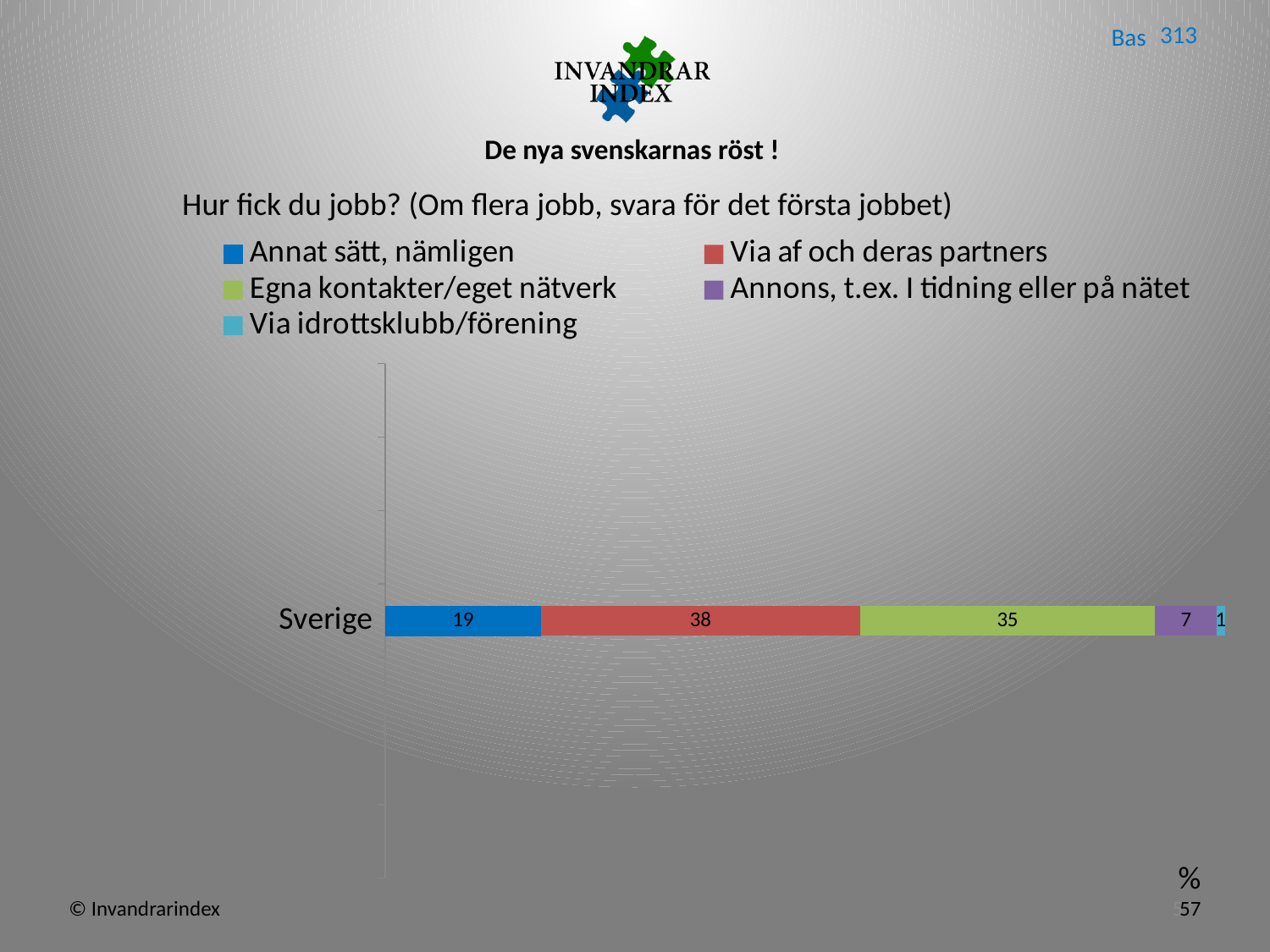
What is the value for "Annons, t.ex. I tidning eller på nätet" in the Sverige bar? 7 Which is larger: the value for "Egna kontakter/eget nätverk" or the value for "Annat sätt, nämligen"? Egna kontakter/eget nätverk What is the difference between the values for "Via af och deras partners" and "Annat sätt, nämligen"? 19 Which series has the highest value in the Sverige bar? Via af och deras partners How many series does the legend list? 5 What kind of chart is shown on the slide? Stacked bar chart What is the total of the Sverige stacked bar? 100 Which series has the lowest value in the Sverige bar? Via idrottsklubb/förening What is the value for "Annat sätt, nämligen" in the Sverige bar? 19 What is the question shown as the chart title? Hur fick du jobb? (Om flera jobb, svara för det första jobbet) What is the value for "Via af och deras partners" in the Sverige bar? 38 What is the value for "Egna kontakter/eget nätverk" in the Sverige bar? 35